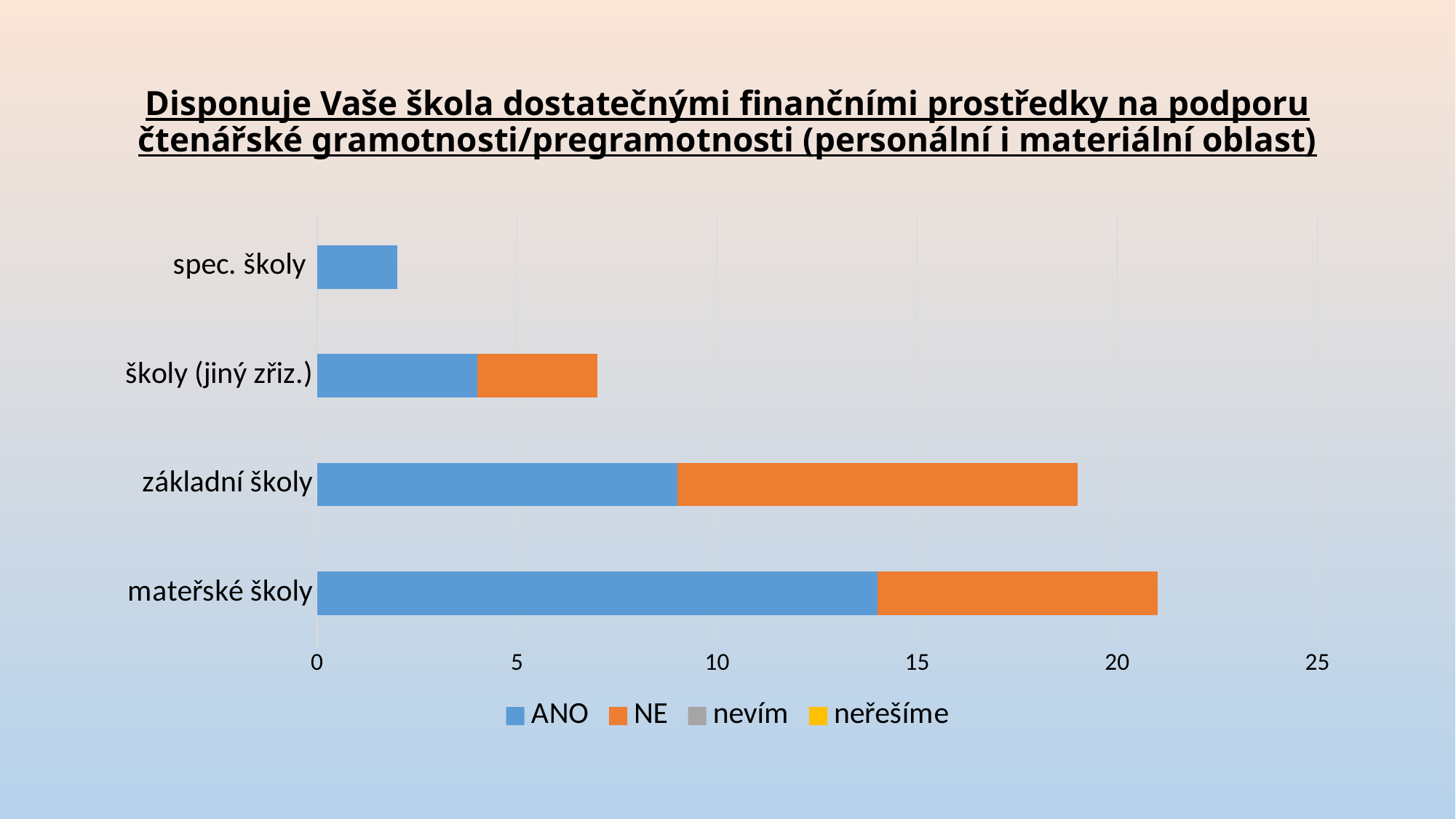
Which legend entries have no visible bars in the chart? nevím and neřešíme Is the ANO value for základní školy greater or less than 10? less Is the total bar for základní školy greater or less than 20? less Is the ANO value for mateřské školy greater or less than 15? less Which category has the longest total bar? mateřské školy What kind of chart is shown on the slide? Stacked bar chart How many series does the legend list? 4 How many school categories are shown on the vertical axis? 4 Which category has the shortest total bar? spec. školy Which has the larger NE segment, základní školy or mateřské školy? základní školy